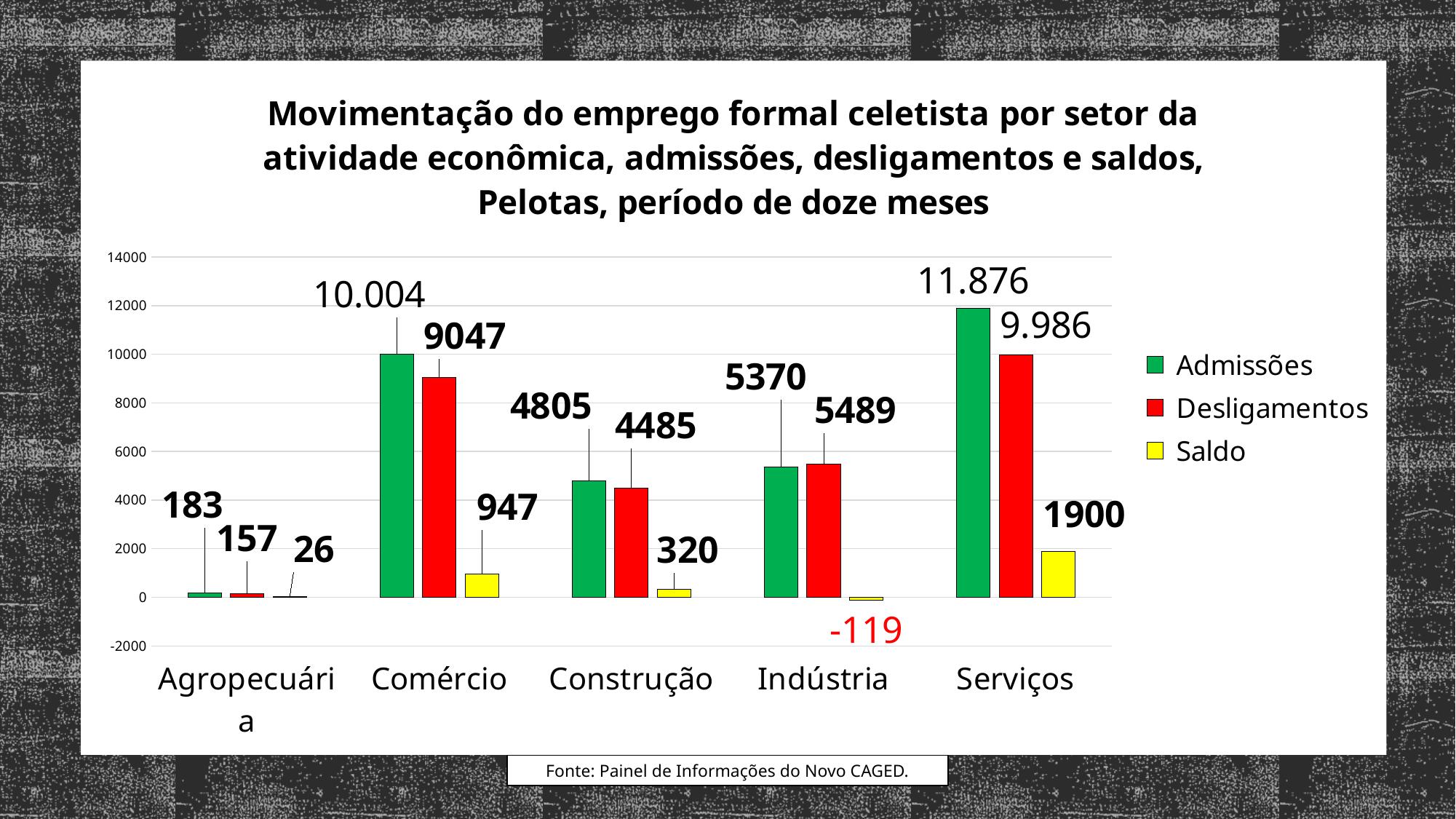
How many series does the legend list? 3 How many sectors (categories) are shown on the x axis? 5 What is the value of Admissões for Serviços? 11.876 What is the value of Admissões for Construção? 4805 What is the value of Desligamentos for Comércio? 9047 Which series is shown in yellow in the legend? Saldo What is the Saldo for Indústria? -119 What type of chart is shown on the slide? bar chart What is the difference between Admissões and Desligamentos for Construção? 320 Which sector has the highest Admissões value? Serviços Which sector has the lowest Saldo value? Indústria Which is larger for Indústria, Admissões or Desligamentos? Desligamentos